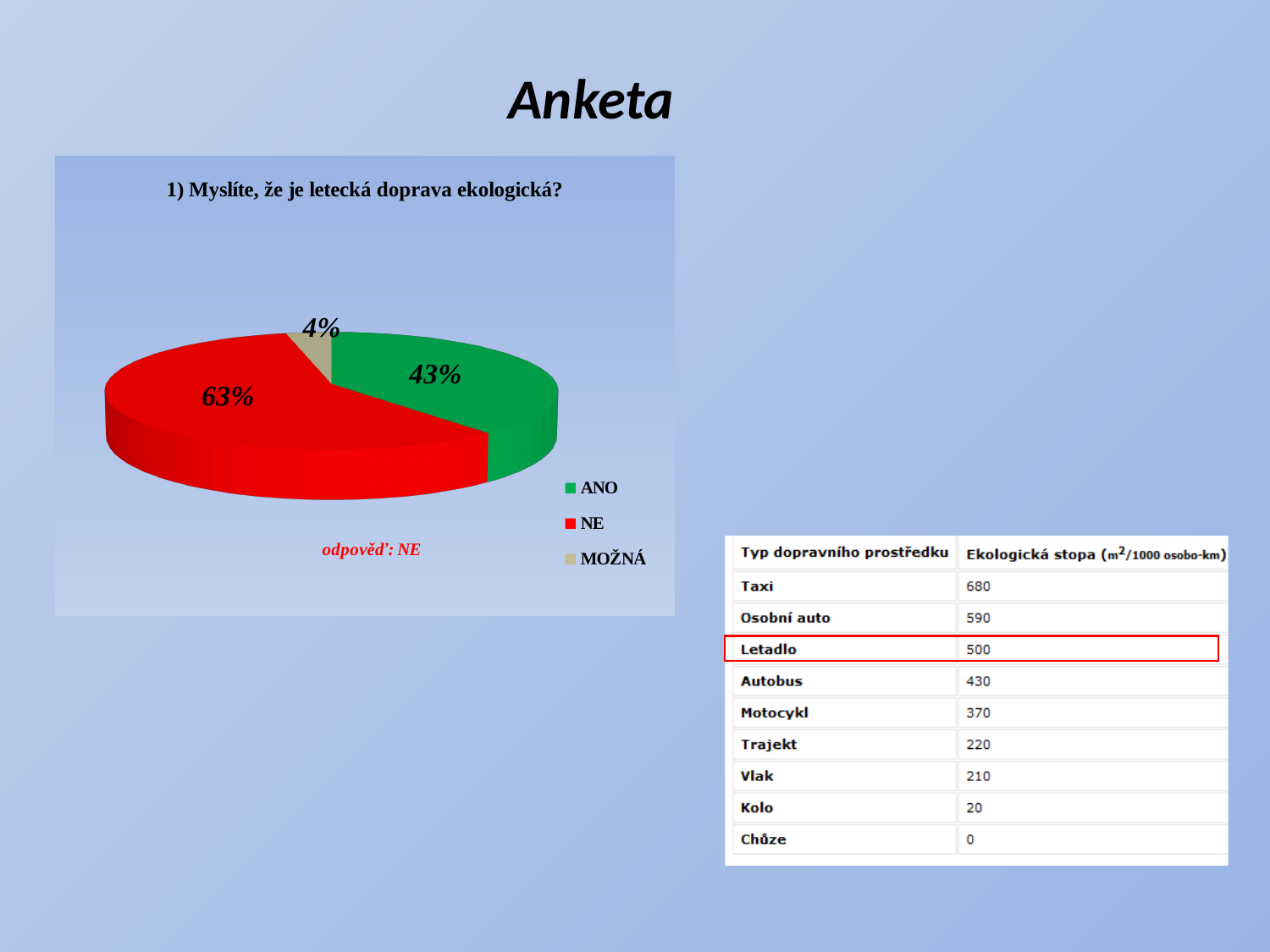
Which slice of the pie chart is the smallest? MOŽNÁ What percentage of the pie chart is labelled NE? 63% How many slices does the pie chart have? 3 What type of chart is shown on the slide? pie chart What is the difference between the NE and ANO percentages in the pie chart? 20% What percentage of the pie chart is labelled MOŽNÁ? 4% How many entries does the legend of the pie chart list? 3 What colour is the NE slice in the pie chart? red What is the title of the pie chart? 1) Myslíte, že je letecká doprava ekologická? What percentage of the pie chart is labelled ANO? 43% Which is larger in the pie chart, ANO or NE? NE Which slice of the pie chart is the largest? NE